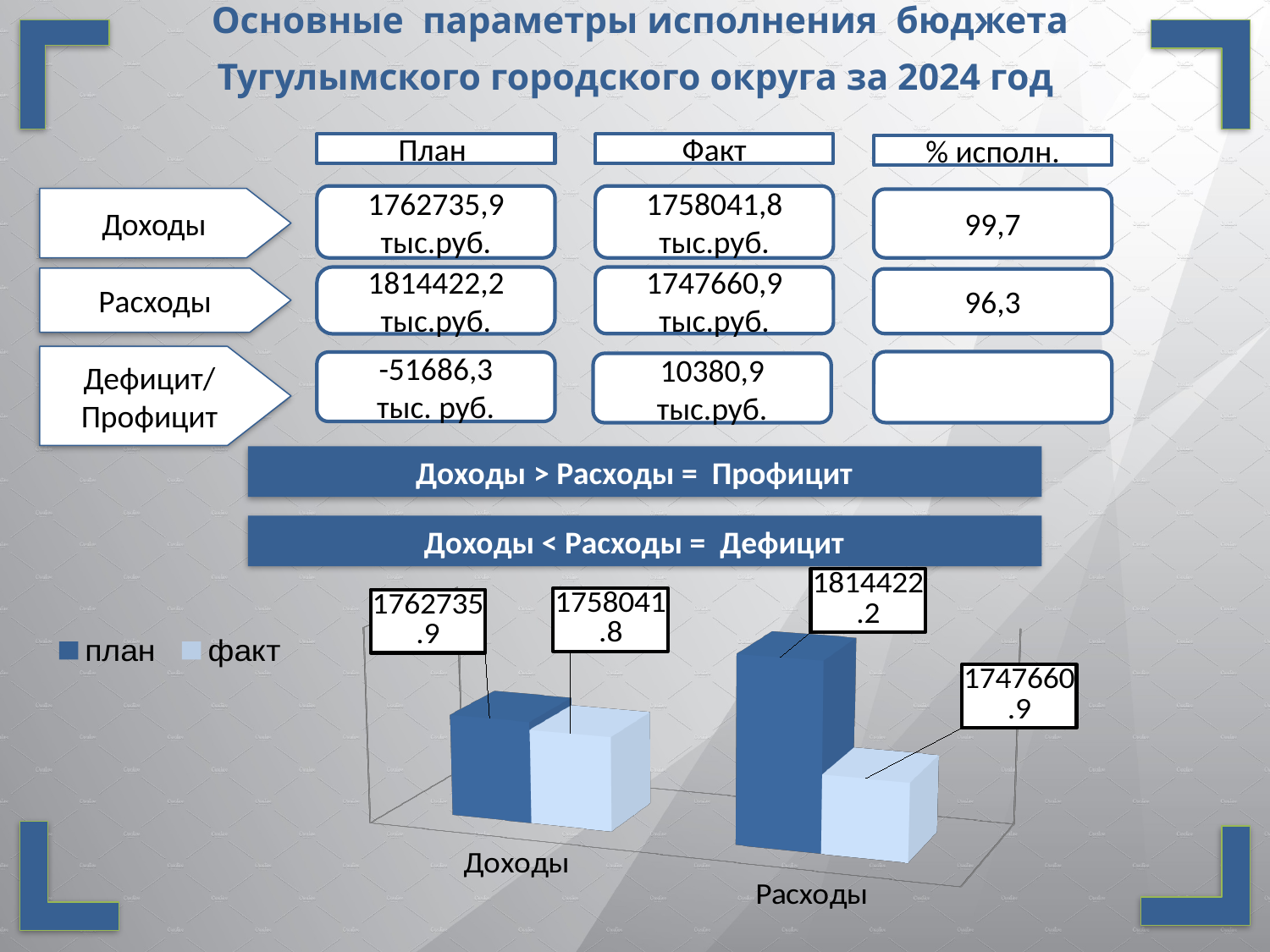
What is the difference between план and факт for Расходы in the chart? 66761.3 What kind of chart is shown at the bottom of the slide? bar chart How many categories are shown on the chart's x axis? 2 What is the value of the факт series for Расходы in the chart? 1747660.9 What are the two series names shown in the chart legend? план and факт What is the value of the план series for Расходы in the chart? 1814422.2 What is the value of the план series for Доходы in the chart? 1762735.9 For Расходы, which is larger in the chart: план or факт? план Which bar in the chart has the highest value? план for Расходы Which bar in the chart has the lowest value? факт for Расходы How many series does the chart legend list? 2 What is the value of the факт series for Доходы in the chart? 1758041.8